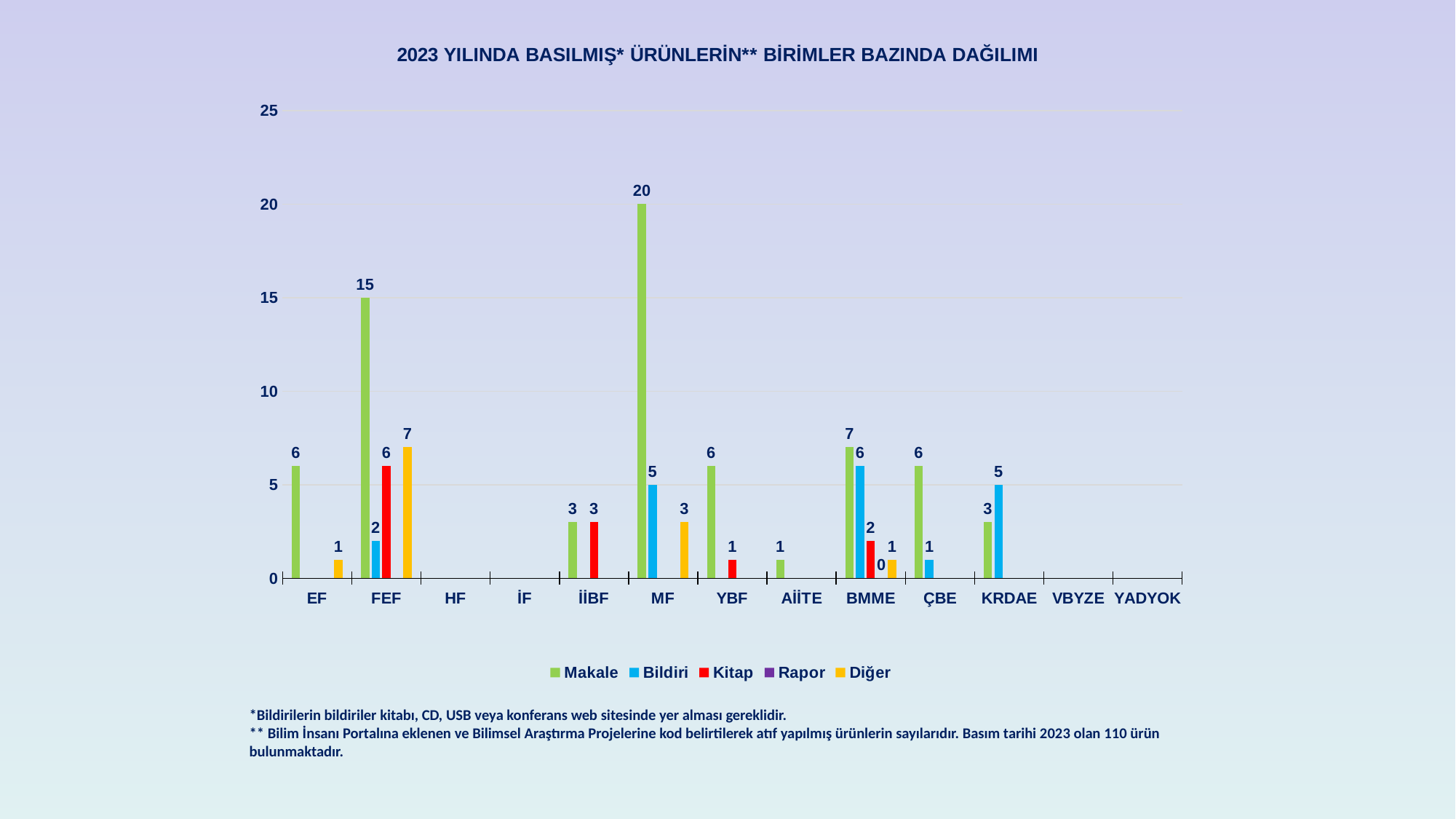
What is the Diğer value for FEF? 7 What is the Makale value for MF? 20 Which series is shown in red in the legend? Kitap How many series does the legend list? 5 How many categories are shown on the x axis? 13 Which category has the highest Makale value? MF Which is larger, the Bildiri value for BMME or the Bildiri value for FEF? BMME Is the Makale value for FEF greater or less than 10? greater What is the difference between the Makale values for MF and FEF? 5 What is the Bildiri value for KRDAE? 5 What kind of chart is shown on the slide? bar chart What is the Kitap value for BMME? 2